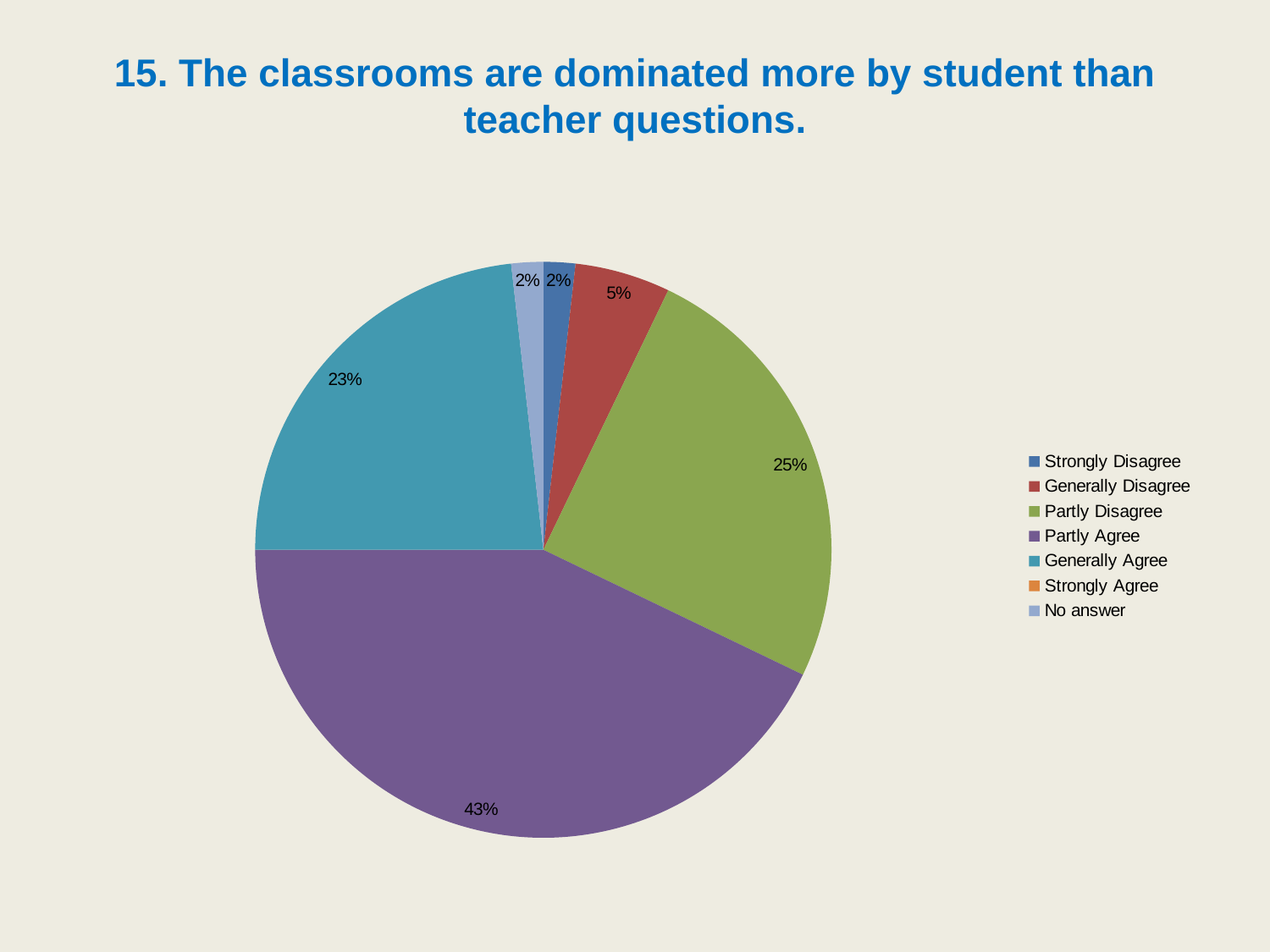
What is the difference in percentage points between Generally Agree and Generally Disagree? 18 What is the difference in percentage points between Partly Agree and Partly Disagree? 18 What is the title of the chart? 15. The classrooms are dominated more by student than teacher questions. What percentage of respondents chose Partly Agree? 43% Which response category has the largest share of the pie? Partly Agree What percentage of respondents chose Partly Disagree? 25% What percentage of respondents chose Strongly Disagree? 2% Which is larger, the share for Partly Disagree or the share for Generally Agree? Partly Disagree What percentage of respondents chose Generally Disagree? 5% What percentage of respondents chose Generally Agree? 23% What type of chart is shown on the slide? pie chart How many entries does the legend list? 7